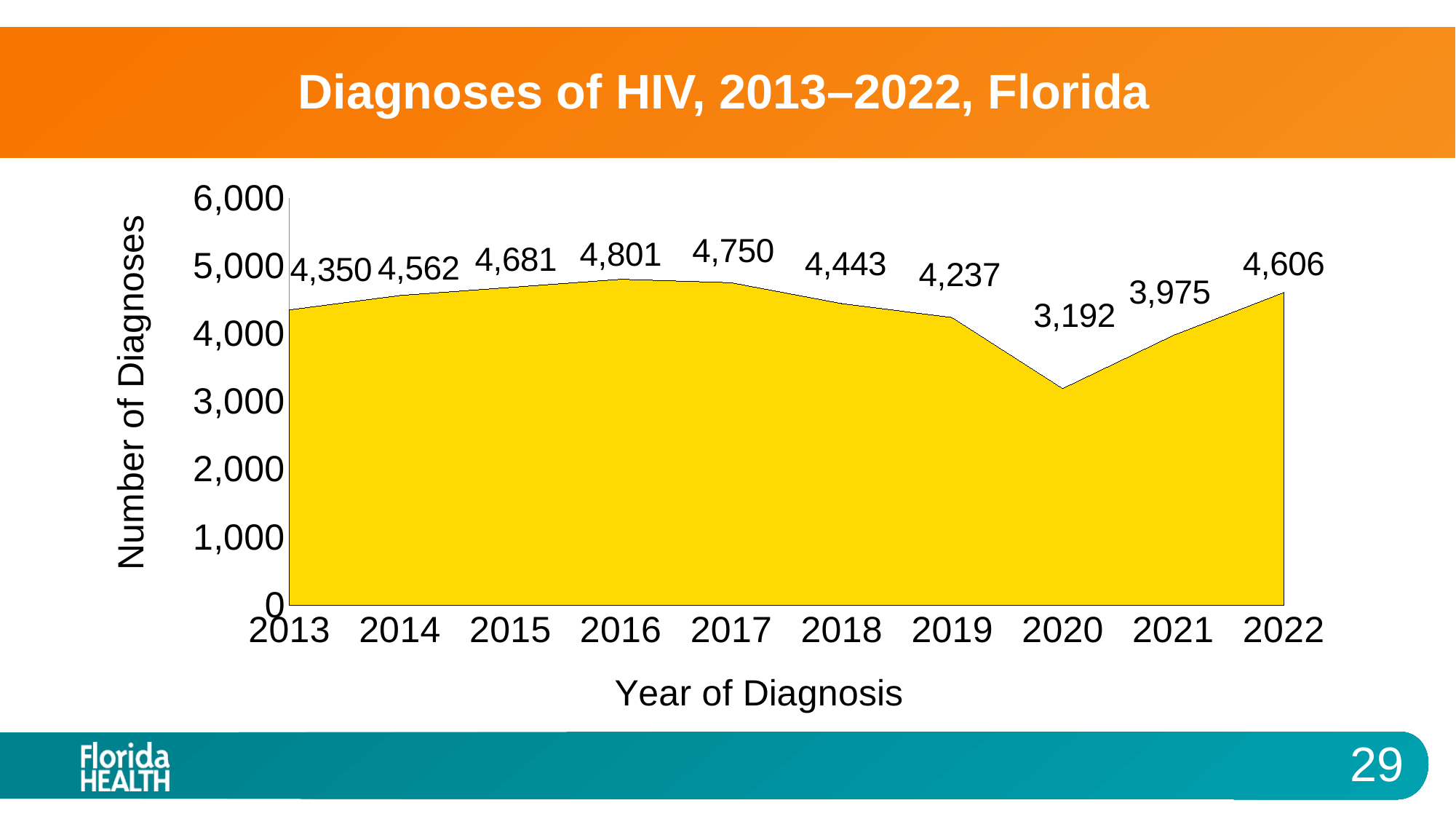
Which year has the lowest number of HIV diagnoses? 2020 What is the number of HIV diagnoses in 2020? 3,192 How many years are plotted on the chart? 10 Is the value for 2021 greater or less than 4,000? less Which year had more HIV diagnoses, 2017 or 2018? 2017 What is the number of HIV diagnoses in 2016? 4,801 What is the title of the chart? Diagnoses of HIV, 2013–2022, Florida What kind of chart is shown on the slide? Area chart What is the difference in HIV diagnoses between 2022 and 2021? 631 What is the number of HIV diagnoses in 2013? 4,350 Which year has the highest number of HIV diagnoses? 2016 What is the difference in HIV diagnoses between 2016 and 2020? 1,609